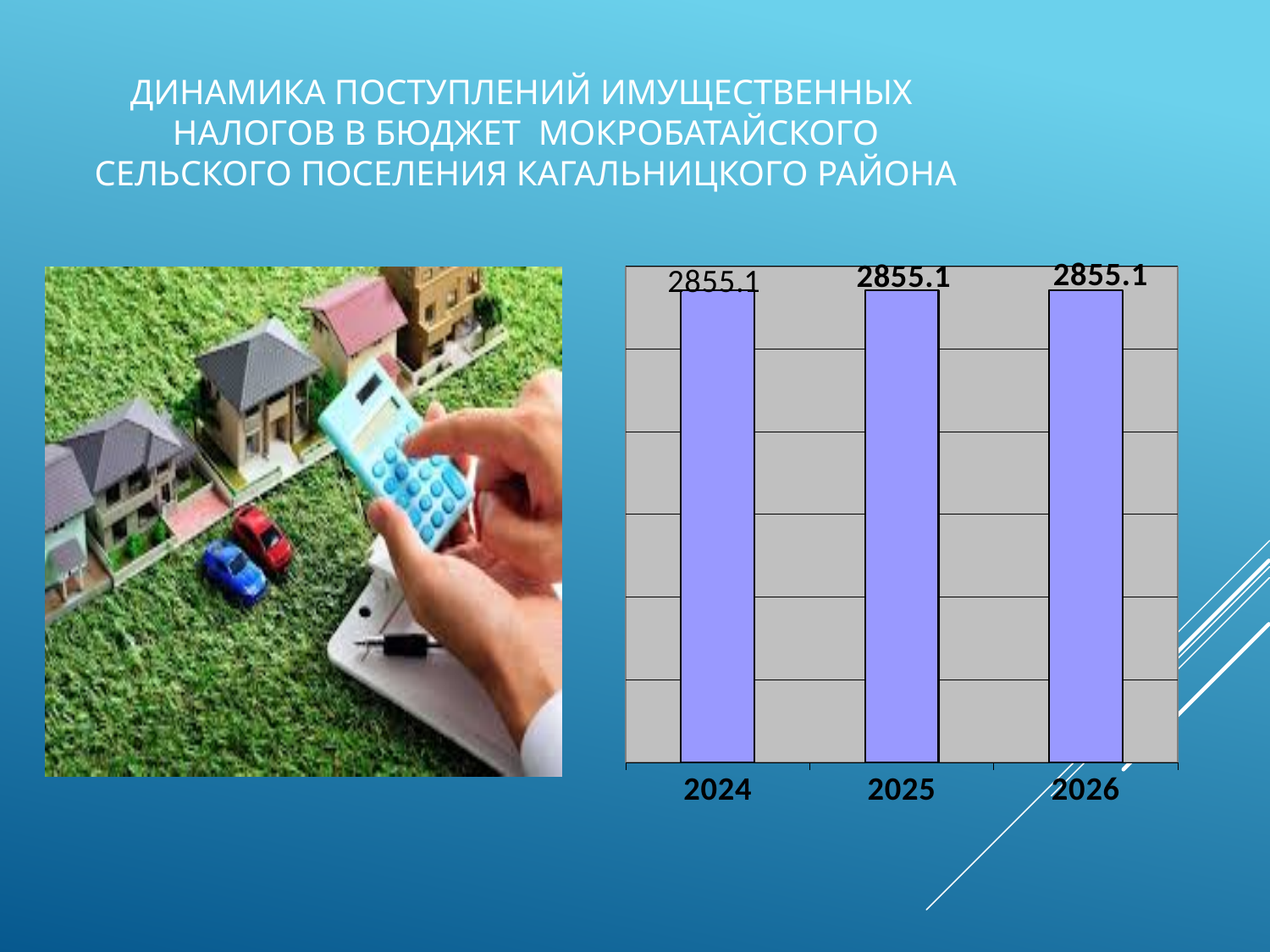
What kind of chart is shown on the slide? bar chart What colour are the bars in the chart? blue (light purple-blue) How many bars are plotted in the chart? 3 What is the difference between the values for 2024 and 2026? 0 What is the value for 2026? 2855.1 What is the value for 2024? 2855.1 Which years are shown on the x axis of the chart? 2024, 2025, 2026 Is the value for 2025 larger than, smaller than, or equal to the value for 2024? equal Do the values rise, fall, or stay the same from 2024 to 2026? stay the same What is the value for 2025? 2855.1